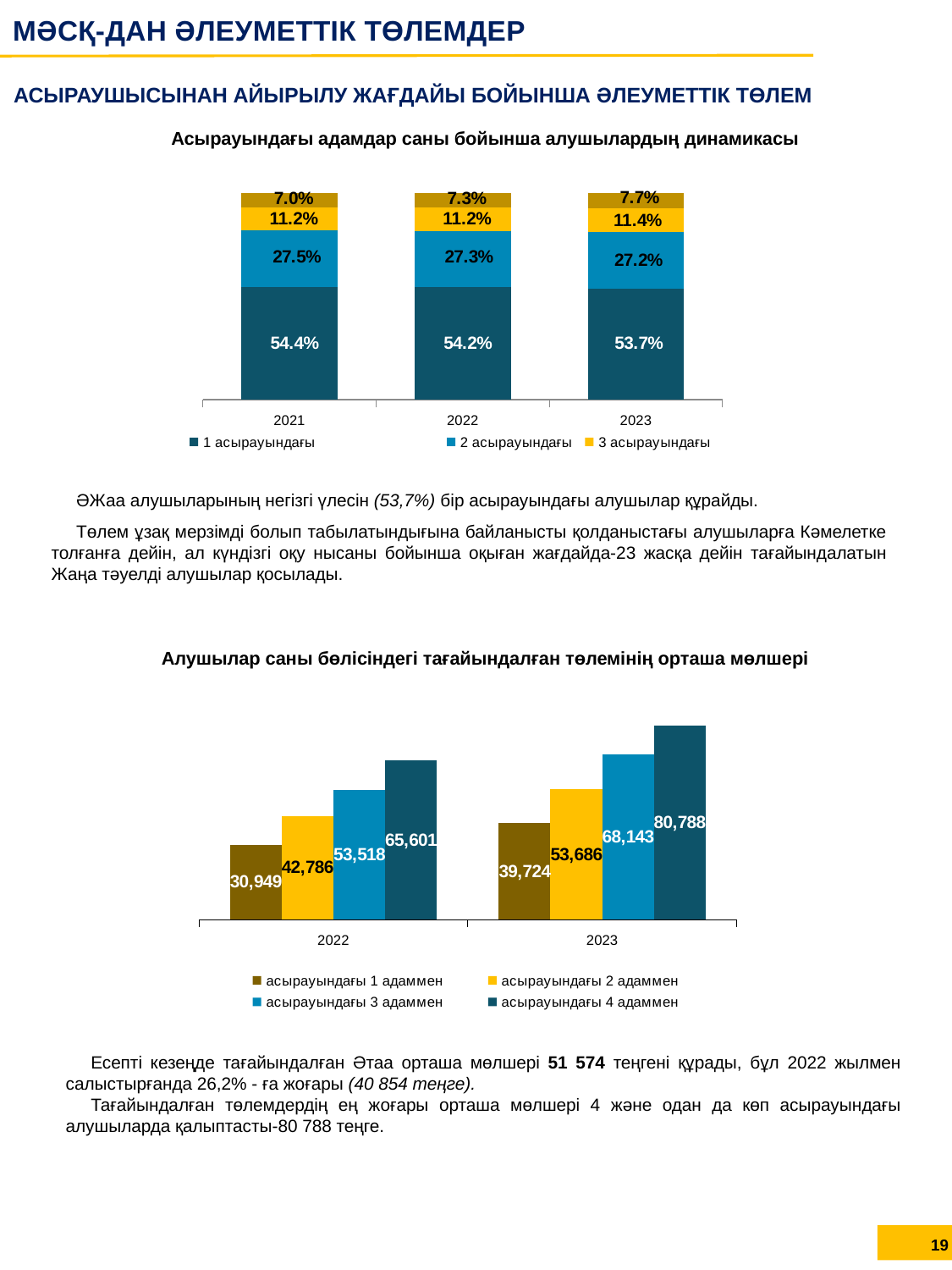
In the bottom chart 'Алушылар саны бөлісіндегі тағайындалған төлемінің орташа мөлшері', how many series does the legend list? 4 In the top chart 'Асырауындағы адамдар саны бойынша алушылардың динамикасы', what is the value of the topmost segment for 2022? 7.3% In the top chart 'Асырауындағы адамдар саны бойынша алушылардың динамикасы', what is the difference between the '1 асырауындағы' values for 2021 and 2023? 0.7% In the top chart 'Асырауындағы адамдар саны бойынша алушылардың динамикасы', what is the value of the '1 асырауындағы' segment for 2023? 53.7% In the bottom chart 'Алушылар саны бөлісіндегі тағайындалған төлемінің орташа мөлшері', what is the difference between 'асырауындағы 3 адаммен' in 2023 and in 2022? 14,625 In the bottom chart 'Алушылар саны бөлісіндегі тағайындалған төлемінің орташа мөлшері', which bar is the lowest? асырауындағы 1 адаммен, 2022 (30,949) In the top chart 'Асырауындағы адамдар саны бойынша алушылардың динамикасы', what is the value of the '2 асырауындағы' segment for 2021? 27.5% In the bottom chart 'Алушылар саны бөлісіндегі тағайындалған төлемінің орташа мөлшері', what is the value for 'асырауындағы 1 адаммен' in 2022? 30,949 What kind of chart is the bottom chart 'Алушылар саны бөлісіндегі тағайындалған төлемінің орташа мөлшері'? bar chart In the bottom chart 'Алушылар саны бөлісіндегі тағайындалған төлемінің орташа мөлшері', what is the value for 'асырауындағы 4 адаммен' in 2023? 80,788 In the top chart 'Асырауындағы адамдар саны бойынша алушылардың динамикасы', how many years are shown on the x axis? 3 In the top chart 'Асырауындағы адамдар саны бойынша алушылардың динамикасы', does the '1 асырауындағы' share rise or fall from 2021 to 2023? fall